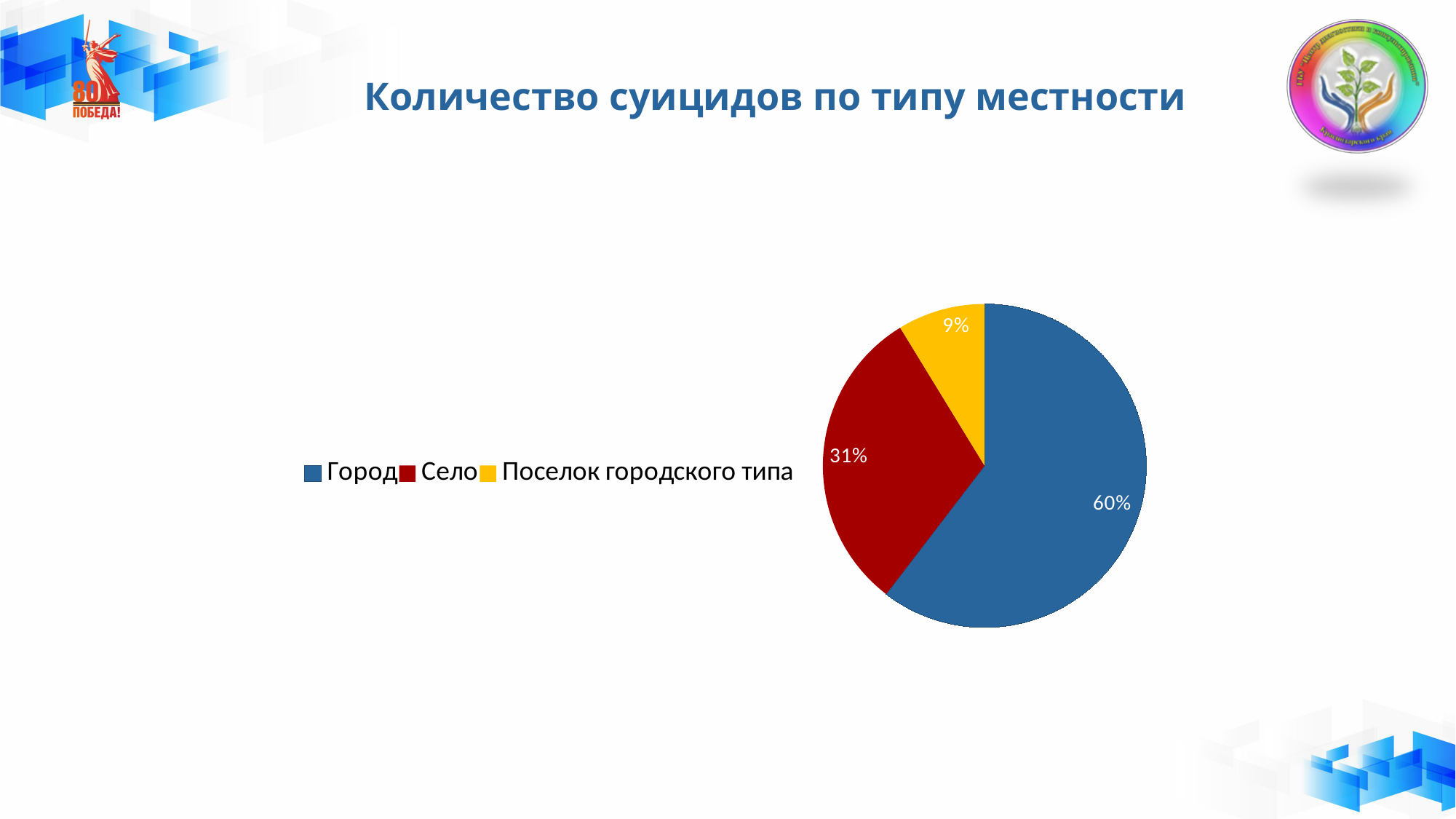
Which category has the smallest slice of the pie? Поселок городского типа Which is larger, the share for Село or the share for Поселок городского типа? Село What colour is the slice for Село? Red What share of the pie does Поселок городского типа account for? 9% What kind of chart is shown on the slide? Pie chart What is the title of the chart? Количество суицидов по типу местности Which category has the largest slice of the pie? Город What share of the pie does Город account for? 60% What share of the pie does Село account for? 31% What is the difference in percentage points between Село and Поселок городского типа? 22% What is the difference in percentage points between Город and Село? 29% How many categories are shown in the pie chart? 3